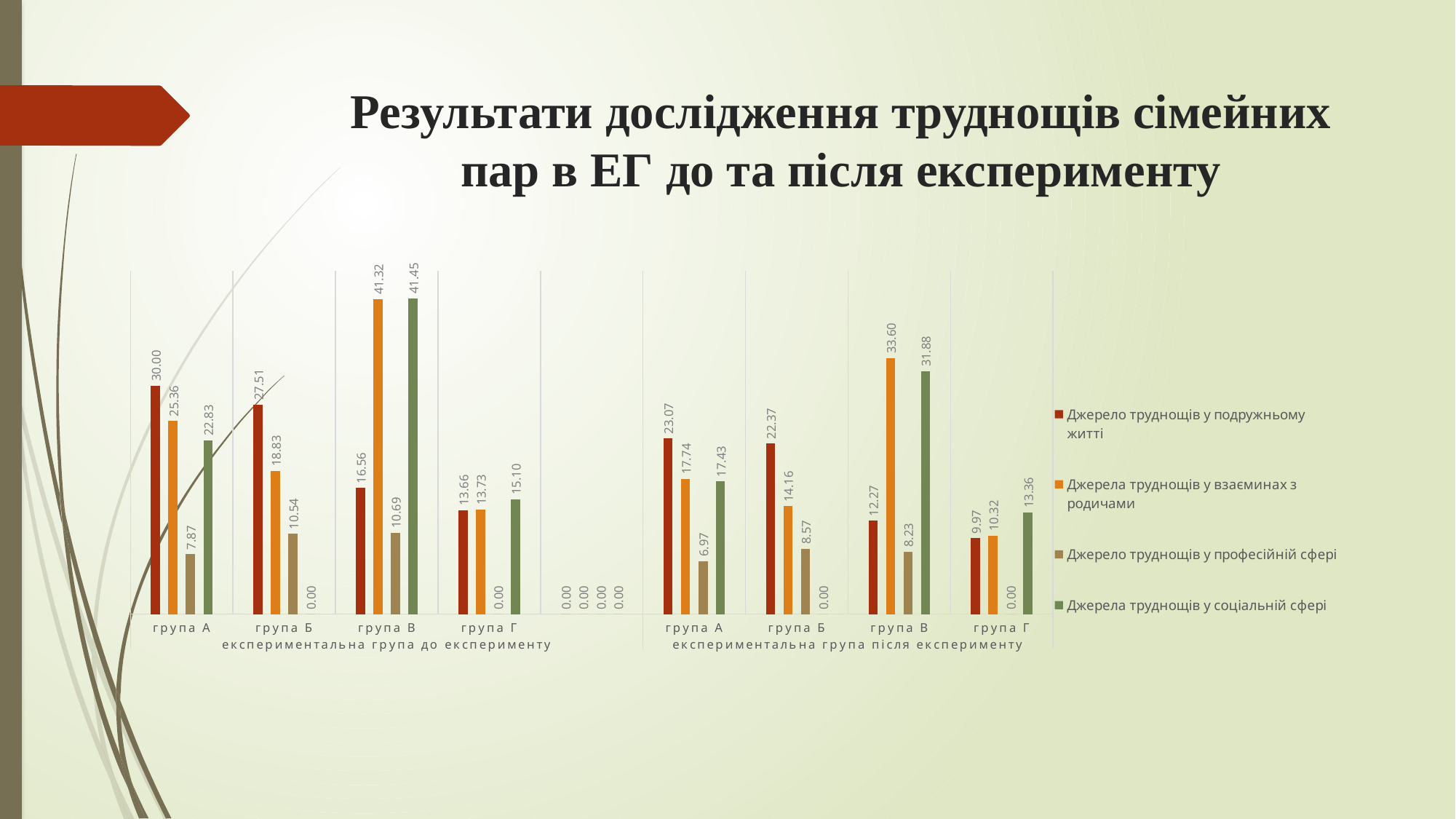
What is the title of the chart on the slide? Результати дослідження труднощів сімейних пар в ЕГ до та після експерименту What is the difference between the "Джерело труднощів у подружньому житті" value for група А before the experiment (30.00) and after the experiment (23.07)? 6.93 Which group has the highest value for "Джерела труднощів у соціальній сфері" in the experimental group before the experiment? група В What is the value of "Джерела труднощів у взаєминах з родичами" for група В in the experimental group before the experiment? 41.32 Which group has the lowest value for "Джерело труднощів у подружньому житті" in the experimental group after the experiment? група Г How many series does the legend list? 4 What is the value of "Джерело труднощів у професійній сфері" for група А in the experimental group after the experiment? 6.97 What is the value of "Джерела труднощів у соціальній сфері" for група В in the experimental group after the experiment? 31.88 What is the value of "Джерело труднощів у подружньому житті" for група А in the experimental group before the experiment? 30.00 What is the value of "Джерело труднощів у професійній сфері" for група Г in the experimental group before the experiment? 0.00 What type of chart is shown on the slide? bar chart Which is larger: "Джерела труднощів у взаєминах з родичами" for група В before the experiment or after the experiment? before the experiment